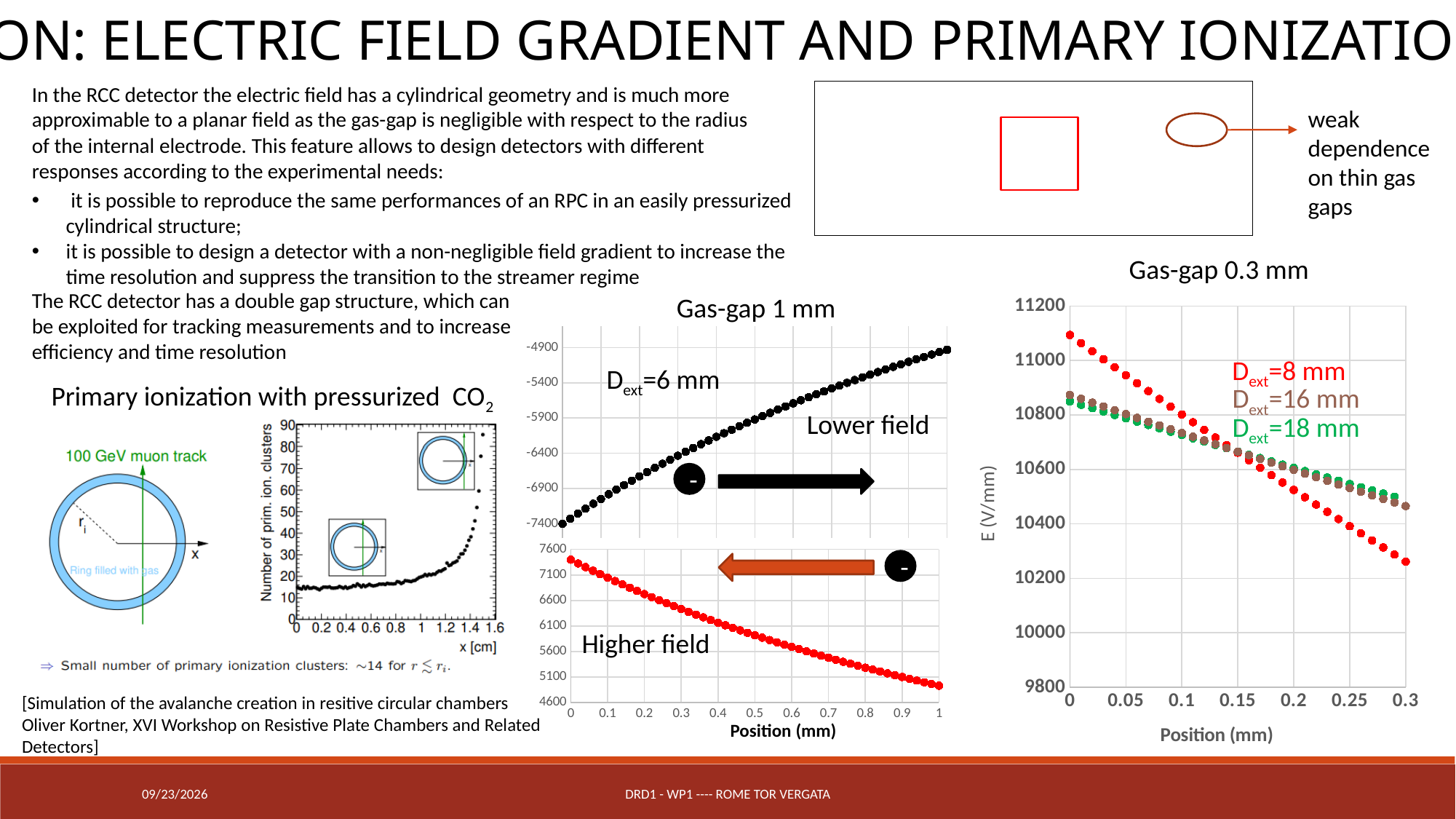
What kind of chart is the Gas-gap 0.3 mm chart? scatter chart In the Gas-gap 0.3 mm chart, at position 0.3 mm, which is larger: the Dext=8 mm series or the Dext=16 mm series? Dext=16 mm In the Gas-gap 0.3 mm chart, which series has the highest value at position 0? Dext=8 mm In the Gas-gap 0.3 mm chart, is the value of the Dext=8 mm series at position 0.3 greater or less than 10400? less In the Gas-gap 0.3 mm chart, which series has the lowest value at position 0.3 mm? Dext=8 mm In the lower Gas-gap 1 mm chart (red points), do the values rise or fall as position increases from 0 to 1 mm? fall In the Gas-gap 0.3 mm chart, is the value of the Dext=8 mm series at position 0 greater or less than 11000? greater In the Gas-gap 0.3 mm chart, what is the label of the y axis? E (V/mm) In the upper Gas-gap 1 mm chart (black points), do the values rise or fall as position increases from 0 to 1 mm? rise In the Gas-gap 0.3 mm chart, how many series are plotted? 3 In the Gas-gap 0.3 mm chart, is the value of the Dext=18 mm series at position 0 greater or less than 11000? less In the Gas-gap 0.3 mm chart, do the values rise or fall as position increases from 0 to 0.3 mm? fall